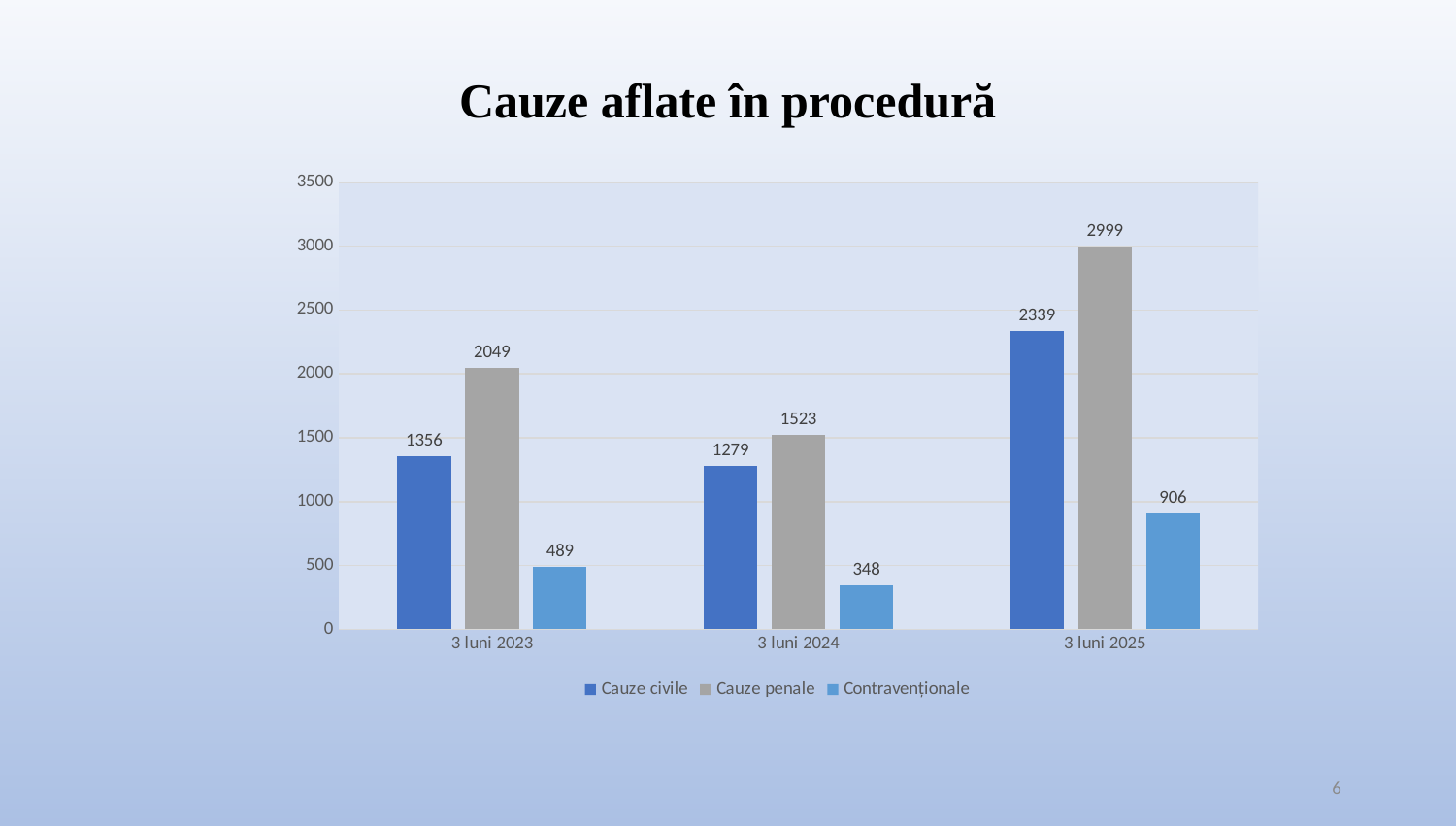
In which period is the value for Contravenționale lowest? 3 luni 2024 Is the value for Contravenționale in 3 luni 2025 greater or less than 1000? less In which period is the value for Cauze civile highest? 3 luni 2025 What is the difference between Cauze penale and Cauze civile in 3 luni 2025? 660 What kind of chart is shown on the slide? bar chart What is the value for Contravenționale in 3 luni 2024? 348 How many periods are shown on the x axis? 3 What is the value for Cauze penale in 3 luni 2025? 2999 Which is larger in 3 luni 2024: Cauze civile or Cauze penale? Cauze penale What is the value for Cauze civile in 3 luni 2023? 1356 What is the title of the chart? Cauze aflate în procedură How many series does the legend list? 3